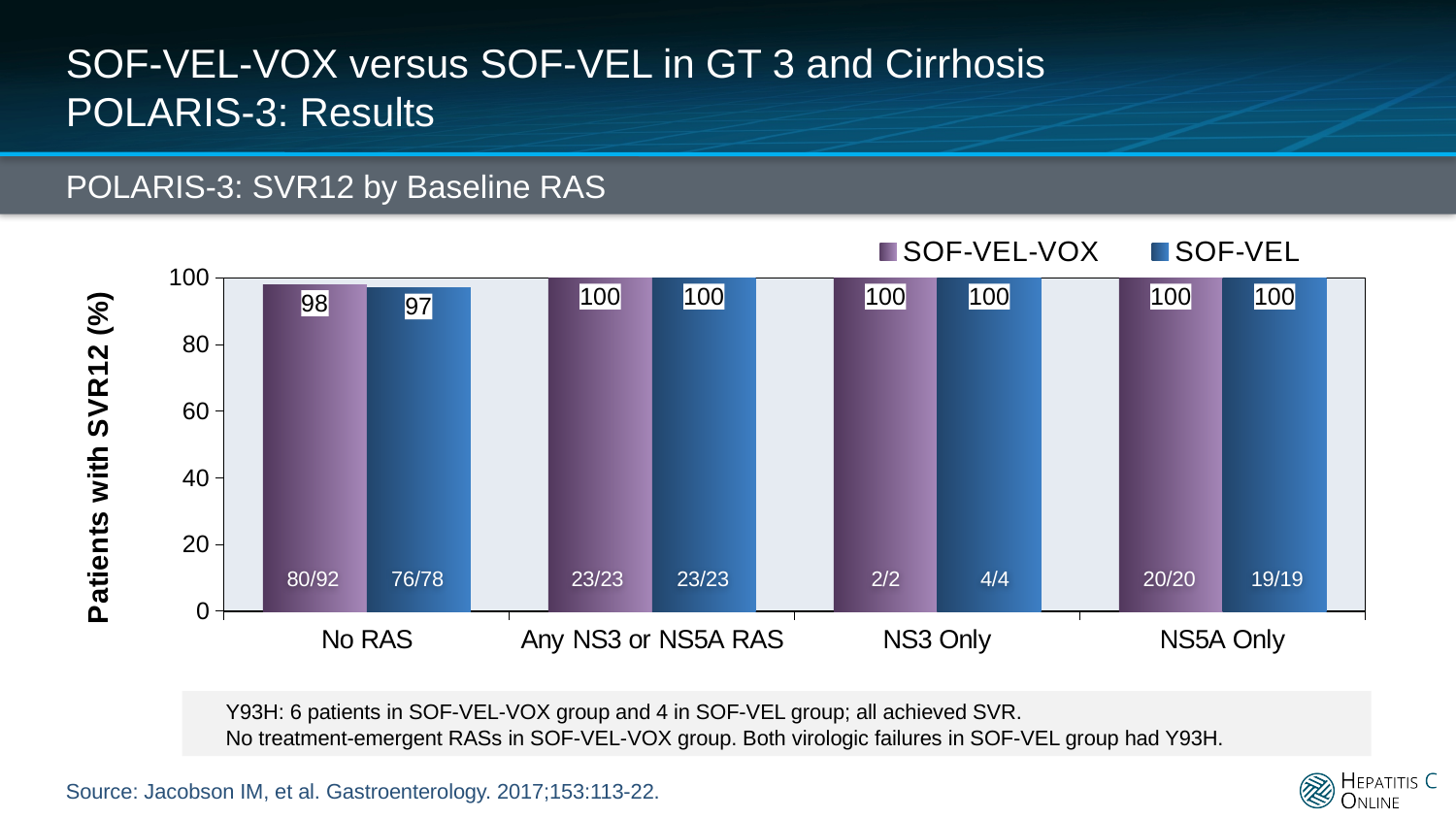
Which category has the lowest SVR12 rate for SOF-VEL? No RAS What is the SVR12 rate for SOF-VEL in the No RAS group? 97 What is the SVR12 rate for SOF-VEL-VOX in the No RAS group? 98 What is the patient fraction shown for SOF-VEL-VOX in the No RAS group? 80/92 Is the SVR12 rate for SOF-VEL-VOX in the No RAS group greater or less than 80? greater What kind of chart is shown on the slide? Bar chart How many baseline RAS categories are shown on the x axis? 4 What is the label of the y axis? Patients with SVR12 (%) What is the SVR12 rate for SOF-VEL in the NS5A Only group? 100 How many series does the legend list? 2 What is the patient fraction shown for SOF-VEL in the NS3 Only group? 4/4 What is the difference between the SOF-VEL-VOX and SOF-VEL SVR12 rates in the No RAS group? 1